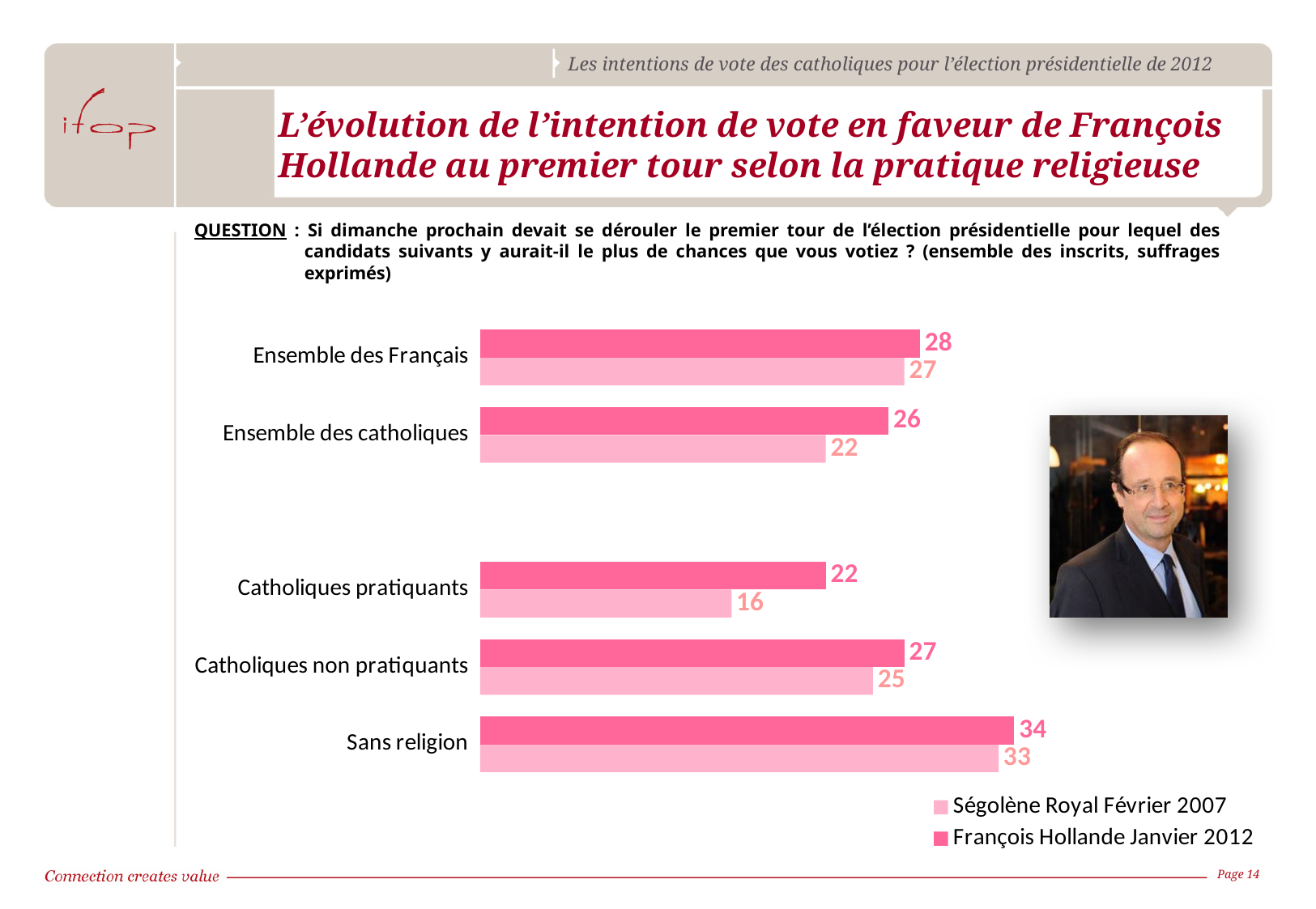
Which series is shown in the lighter pink colour? Ségolène Royal Février 2007 What is the value for François Hollande Janvier 2012 for Ensemble des Français? 28 How many series does the legend list? 2 Which category has the lowest value for Ségolène Royal Février 2007? Catholiques pratiquants What is the value for Ségolène Royal Février 2007 for Catholiques pratiquants? 16 What is the value for François Hollande Janvier 2012 for Sans religion? 34 What is the difference between the François Hollande Janvier 2012 and Ségolène Royal Février 2007 values for Catholiques pratiquants? 6 Which is larger for Catholiques non pratiquants: the François Hollande Janvier 2012 value or the Ségolène Royal Février 2007 value? François Hollande Janvier 2012 What kind of chart is shown on the slide? Bar chart Which category has the highest value for François Hollande Janvier 2012? Sans religion How many categories are shown on the chart? 5 What is the value for Ségolène Royal Février 2007 for Ensemble des catholiques? 22